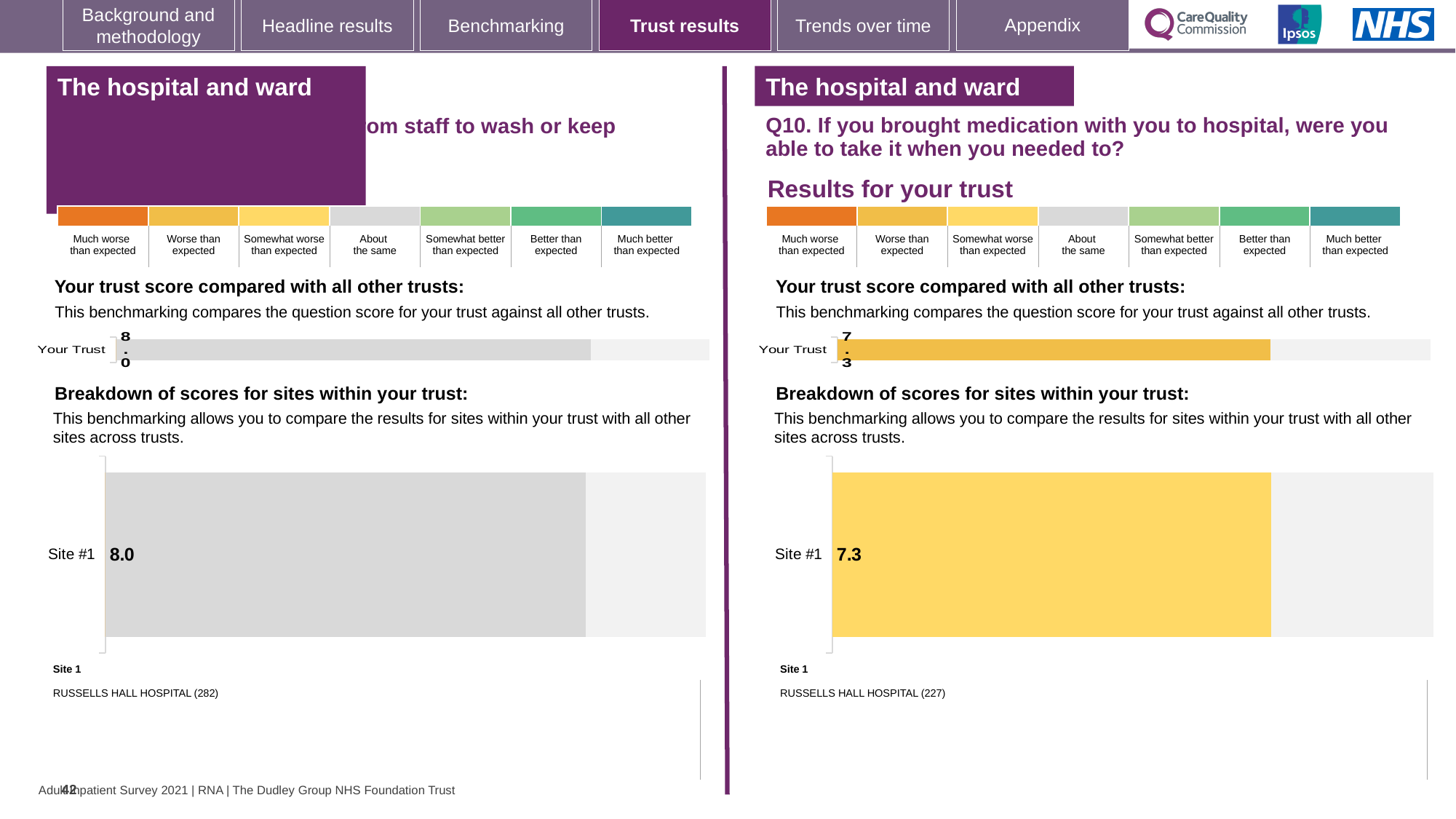
How many sites are shown in the left-hand site breakdown chart? 1 On the right-hand chart for Q10 (medication brought to hospital), what is the score shown for Your Trust? 7.3 Which is larger: the Your Trust score on the left-hand chart or the Your Trust score on the right-hand Q10 chart? Left-hand chart (8.0) On the left-hand site breakdown chart, what is the score for Site #1? 8.0 What type of chart is used to show the Site #1 score on the right-hand Q10 breakdown? Bar chart On the left-hand 'Your trust score compared with all other trusts' chart, what is the score shown for Your Trust? 8.0 What colour is the Site #1 bar on the right-hand Q10 breakdown chart? Yellow What is the difference between the Site #1 score on the left-hand chart (8.0) and the Site #1 score on the right-hand Q10 chart (7.3)? 0.7 How many sites are shown in the right-hand Q10 site breakdown chart? 1 Which site name is listed under the right-hand Q10 site breakdown chart? RUSSELLS HALL HOSPITAL (227) On the right-hand Q10 site breakdown chart, what is the score for Site #1? 7.3 Is the Your Trust score on the right-hand Q10 chart greater or less than 8.0? less